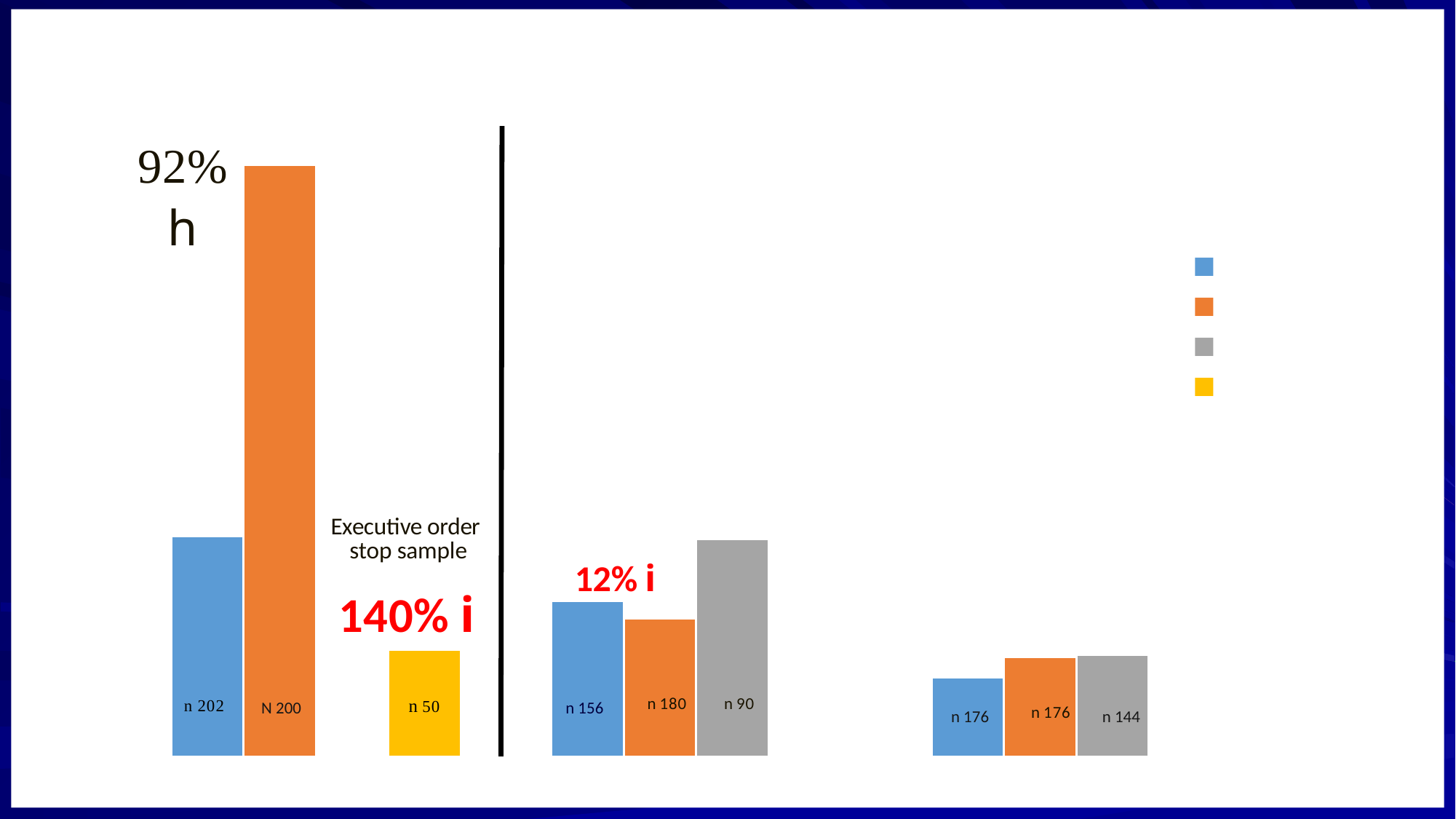
In the middle group of bars (blue, orange, grey), which bar is the tallest? the grey bar What sample-size label is printed on the yellow bar? n 50 What sample-size label is printed on the orange bar in the leftmost group? N 200 How many bars are plotted in total on the chart? 9 In the leftmost group of bars, which bar is taller: the blue bar or the orange bar? the orange bar What percentage annotation in red is printed above the yellow bar? 140% i What sample-size label is printed on the grey bar in the middle group? n 90 How many colour entries does the legend on the right of the chart show? 4 What text label is printed above the yellow bar, just under the vertical black line's top area? Executive order stop sample How many bars are in the group to the left of the vertical black line? 3 What kind of chart is shown on the slide? bar chart In the rightmost group of bars (blue, orange, grey), which bar is the shortest? the blue bar